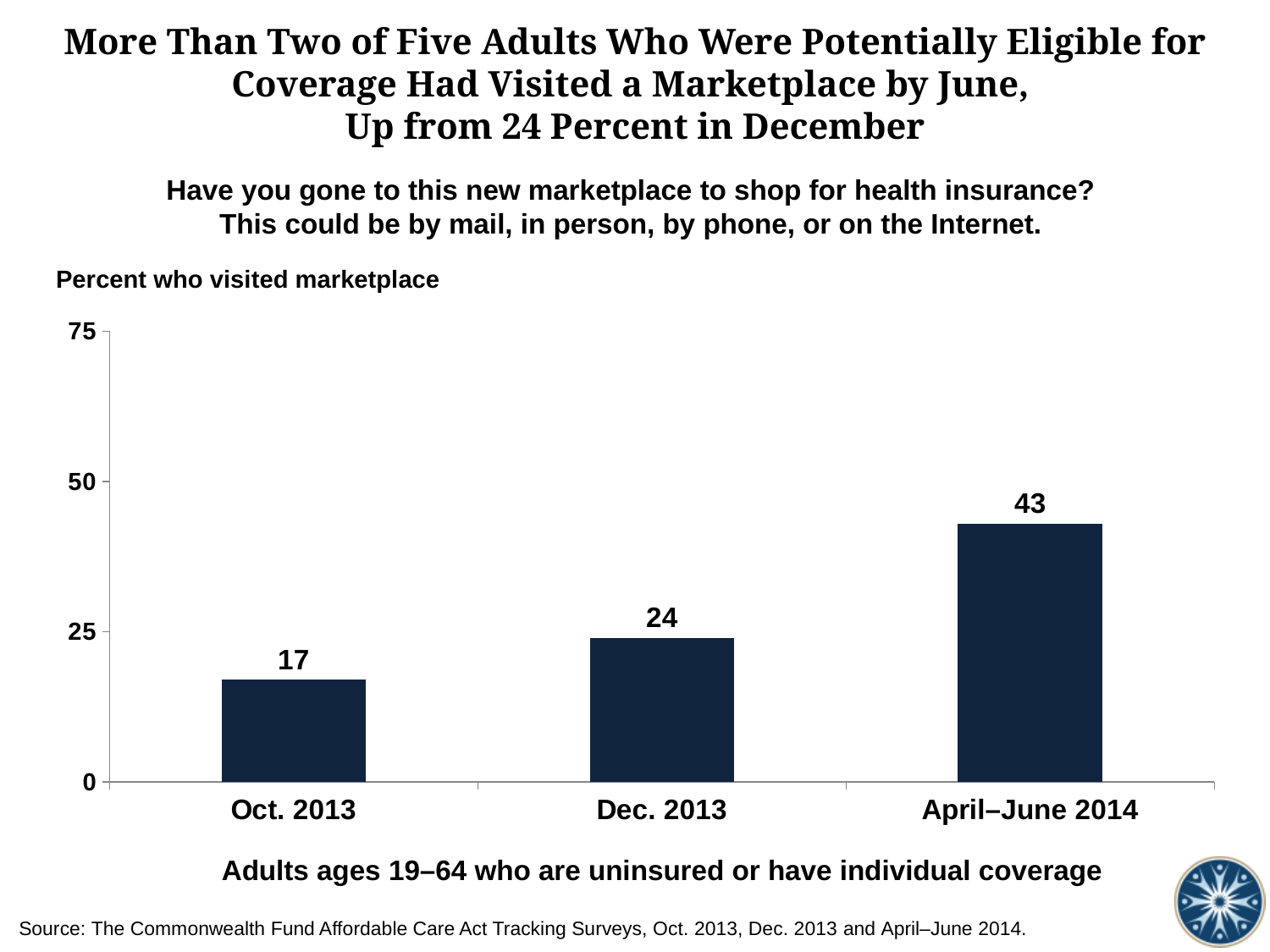
Which period has the lowest percent who visited the marketplace? Oct. 2013 Is the value for April–June 2014 greater or less than 50? less What percent of adults visited the marketplace in Dec. 2013? 24 Do the values rise or fall from Oct. 2013 to April–June 2014? rise What percent of adults visited the marketplace in April–June 2014? 43 What percent of adults visited the marketplace in Oct. 2013? 17 How many time periods are shown on the chart? 3 What kind of chart is shown on the slide? bar chart What is the difference in percent who visited the marketplace between Dec. 2013 and Oct. 2013? 7 What is the difference in percent who visited the marketplace between April–June 2014 and Dec. 2013? 19 Which period has the highest percent who visited the marketplace? April–June 2014 Which is larger, the value for Dec. 2013 or the value for Oct. 2013? Dec. 2013